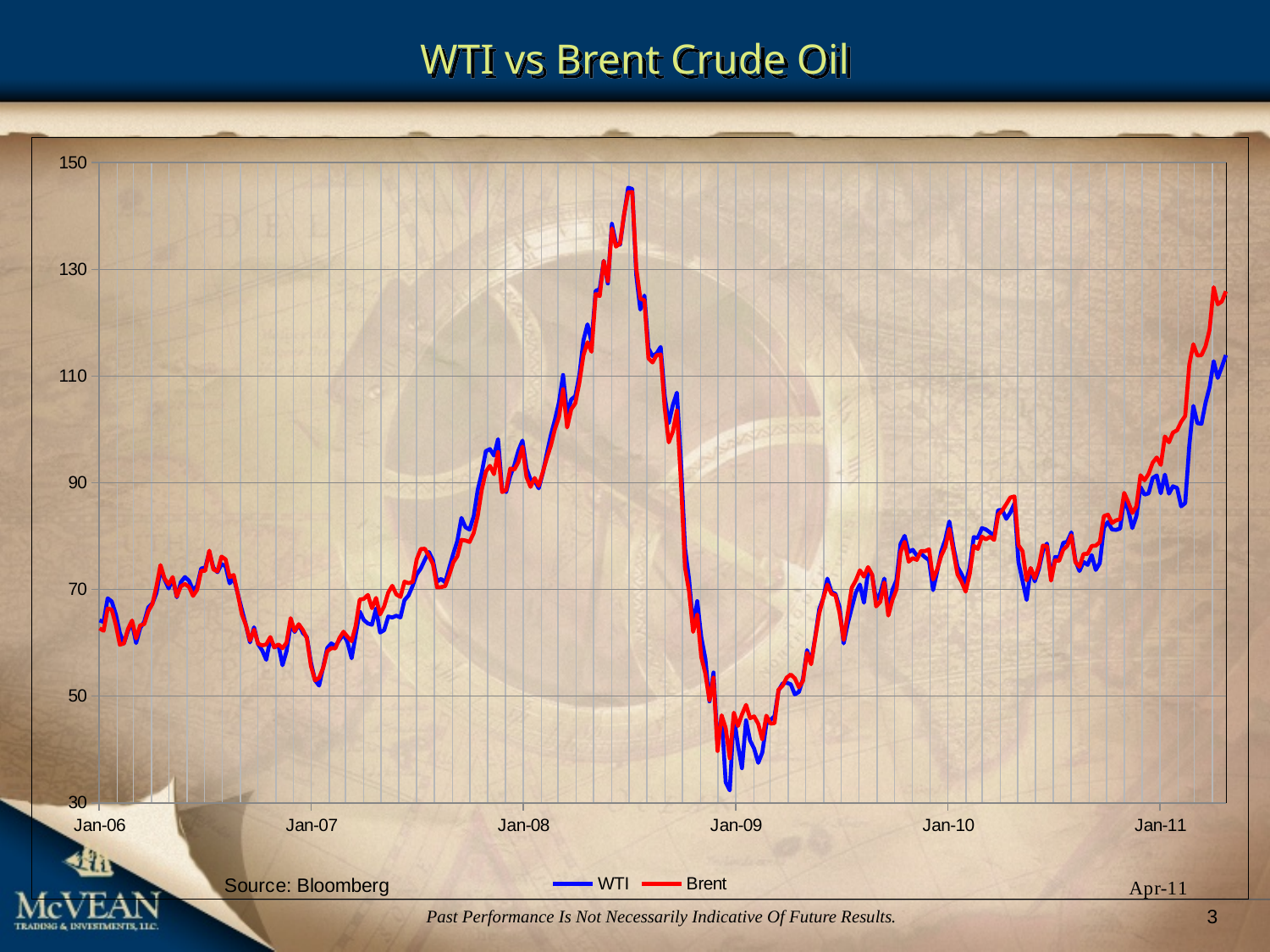
Do the values rise or fall between Jan-09 and Jan-11? rise How many year labels are shown on the x axis? 6 Which colour represents the Brent series in the chart? red Is the peak value of Brent in mid-2008 greater or less than 130? greater Is the value of WTI at Jan-06 greater or less than 70? less What kind of chart is shown on the slide? line chart Is the value of Brent at the right end of the chart (Apr-11) greater or less than 110? greater What is the title of the chart? WTI vs Brent Crude Oil At the right end of the chart, which series is higher, WTI or Brent? Brent How many series does the legend list? 2